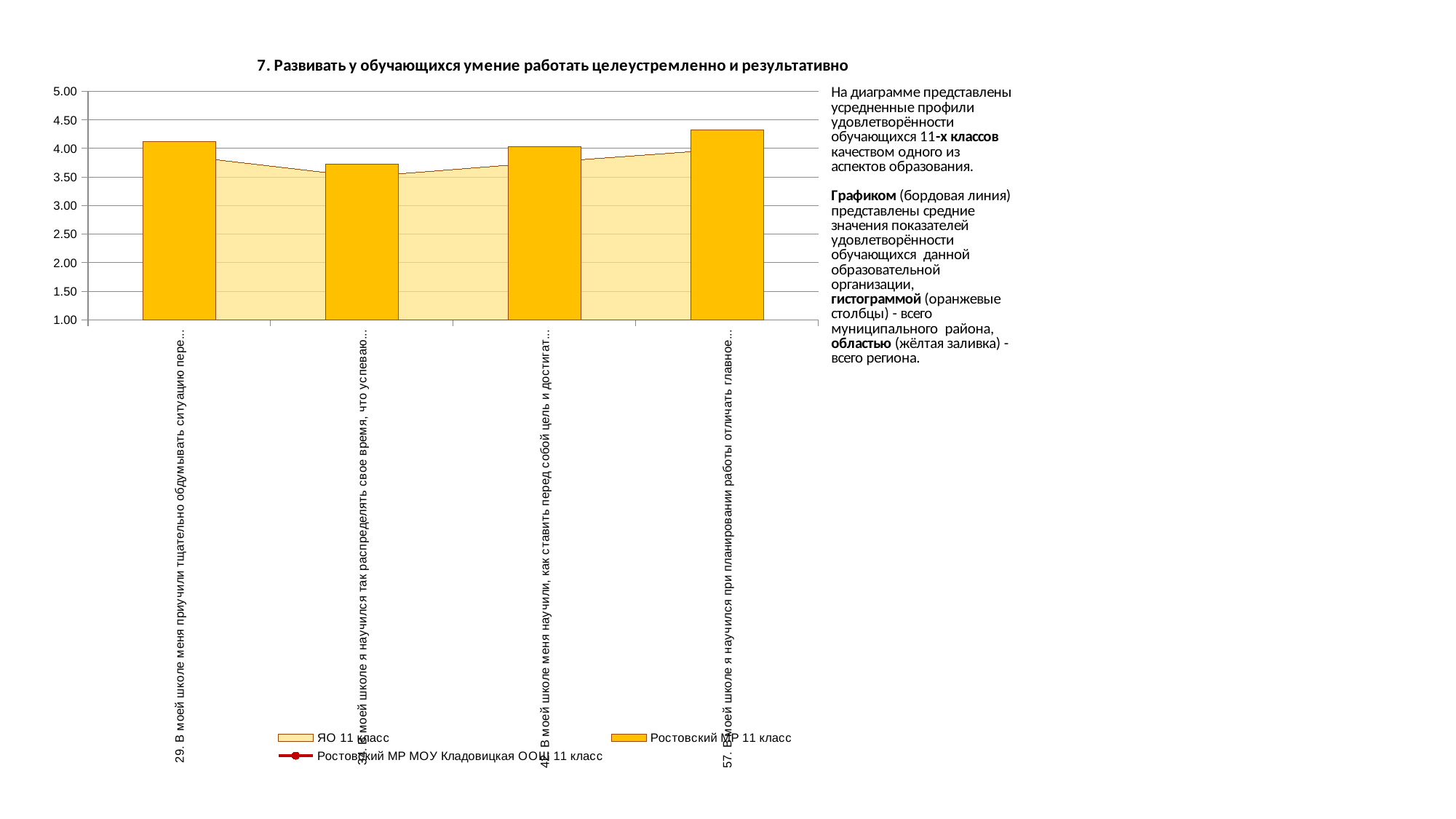
Is the ЯО 11 класс value for category 29 greater or less than 4.00? less Is the Ростовский МР 11 класс value for category 34 greater or less than 4.00? less For category 29, which is larger: the Ростовский МР 11 класс bar or the ЯО 11 класс area value? Ростовский МР 11 класс How many series does the legend list? 3 Which category has the highest orange bar (Ростовский МР 11 класс)? 57. В моей школе я научился при планировании работы отличать главное… What kind of chart is shown on the slide? A bar chart combined with an area series What is the title of the chart? 7. Развивать у обучающихся умение работать целеустремленно и результативно Which is larger for Ростовский МР 11 класс: the value for category 57 or the value for category 34? Category 57 Is the Ростовский МР 11 класс value for category 34 greater or less than 3.50? greater How many categories (questions) are shown along the x axis? 4 Which category has the lowest orange bar (Ростовский МР 11 класс)? 34. В моей школе я научился так распределять свое время, что успеваю…